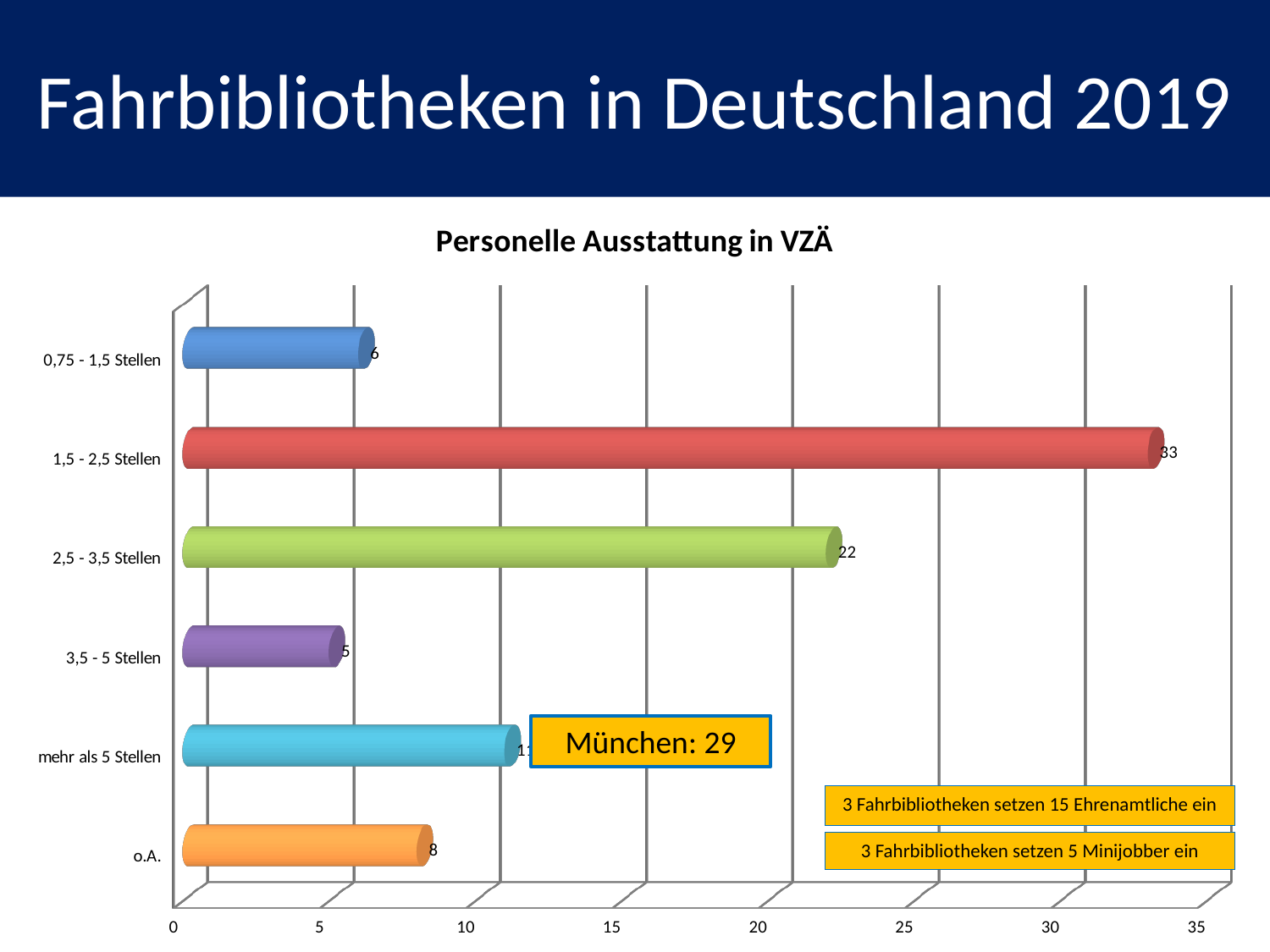
Which is larger, the value for "o.A." or the value for "0,75 - 1,5 Stellen"? o.A. Which category has the lowest value? 3,5 - 5 Stellen What is the difference between the values for "1,5 - 2,5 Stellen" and "2,5 - 3,5 Stellen"? 11 What is the title of the chart? Personelle Ausstattung in VZÄ What is the value for the category "o.A."? 8 What is the value for the category "2,5 - 3,5 Stellen"? 22 What is the value for the category "3,5 - 5 Stellen"? 5 What is the value for the category "1,5 - 2,5 Stellen"? 33 Is the value for "mehr als 5 Stellen" greater or less than 10? greater Which category has the highest value? 1,5 - 2,5 Stellen What kind of chart is shown on the slide? bar chart How many categories are shown in the chart? 6